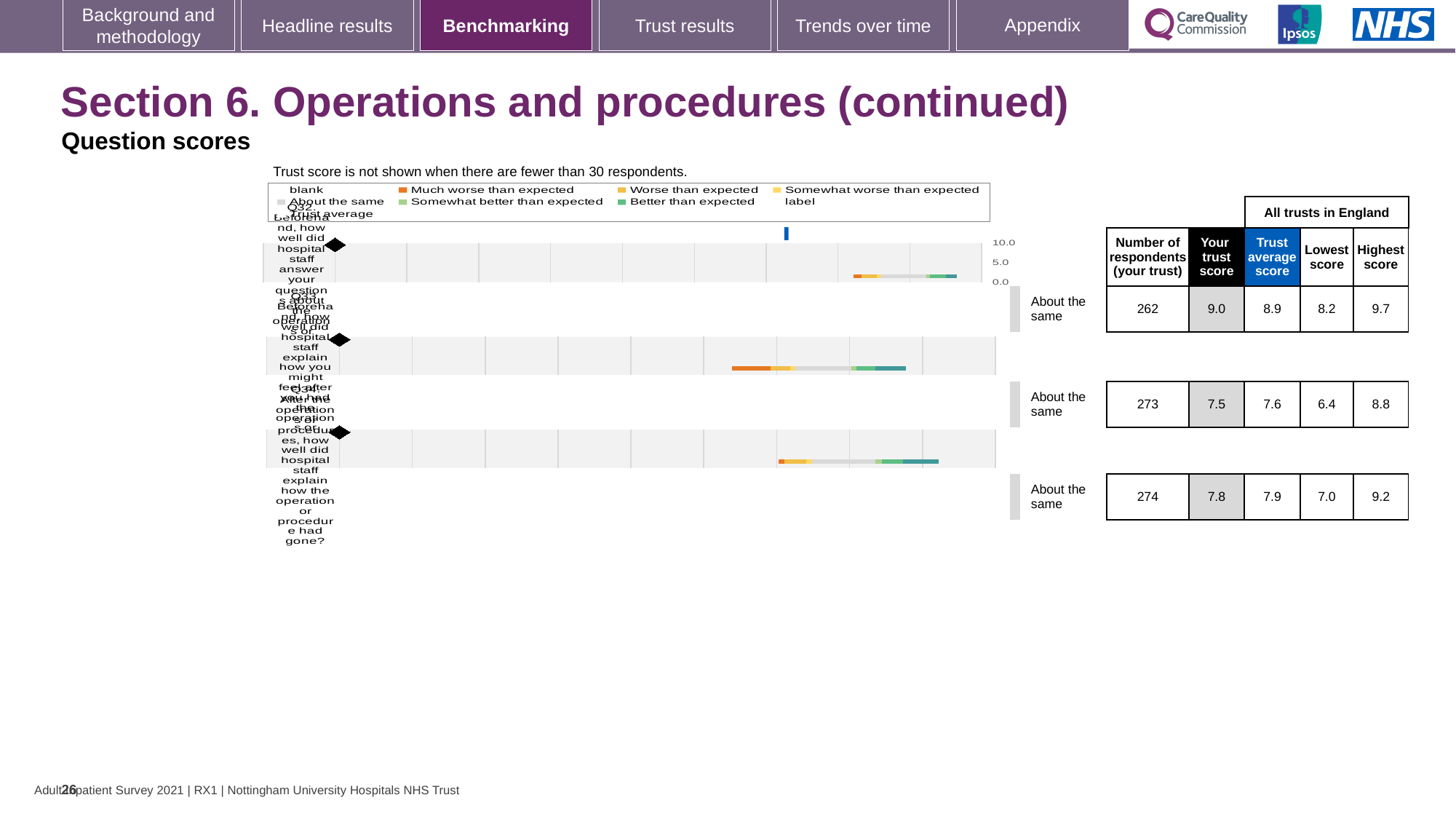
For the top chart (Q32), what is the difference between the highest score and the lowest score across all trusts in England? 1.5 Which of the three questions has the highest trust score? Q32 How many question charts are shown on the slide? 3 Which of the three questions has the lowest 'lowest score' across all trusts in England? Q33 What kind of chart is used to show the question scores? Bar chart What is the trust score shown for the top chart (Q32)? 9.0 How many respondents does the bottom chart (Q34) have for this trust? 274 For the middle chart (Q33), which is larger: the trust score or the trust average score? Trust average score What benchmark category is shown next to each of the three charts? About the same What is the trust average score for the middle chart (Q33)? 7.6 What is the highest score across all trusts in England for the bottom chart (Q34)? 9.2